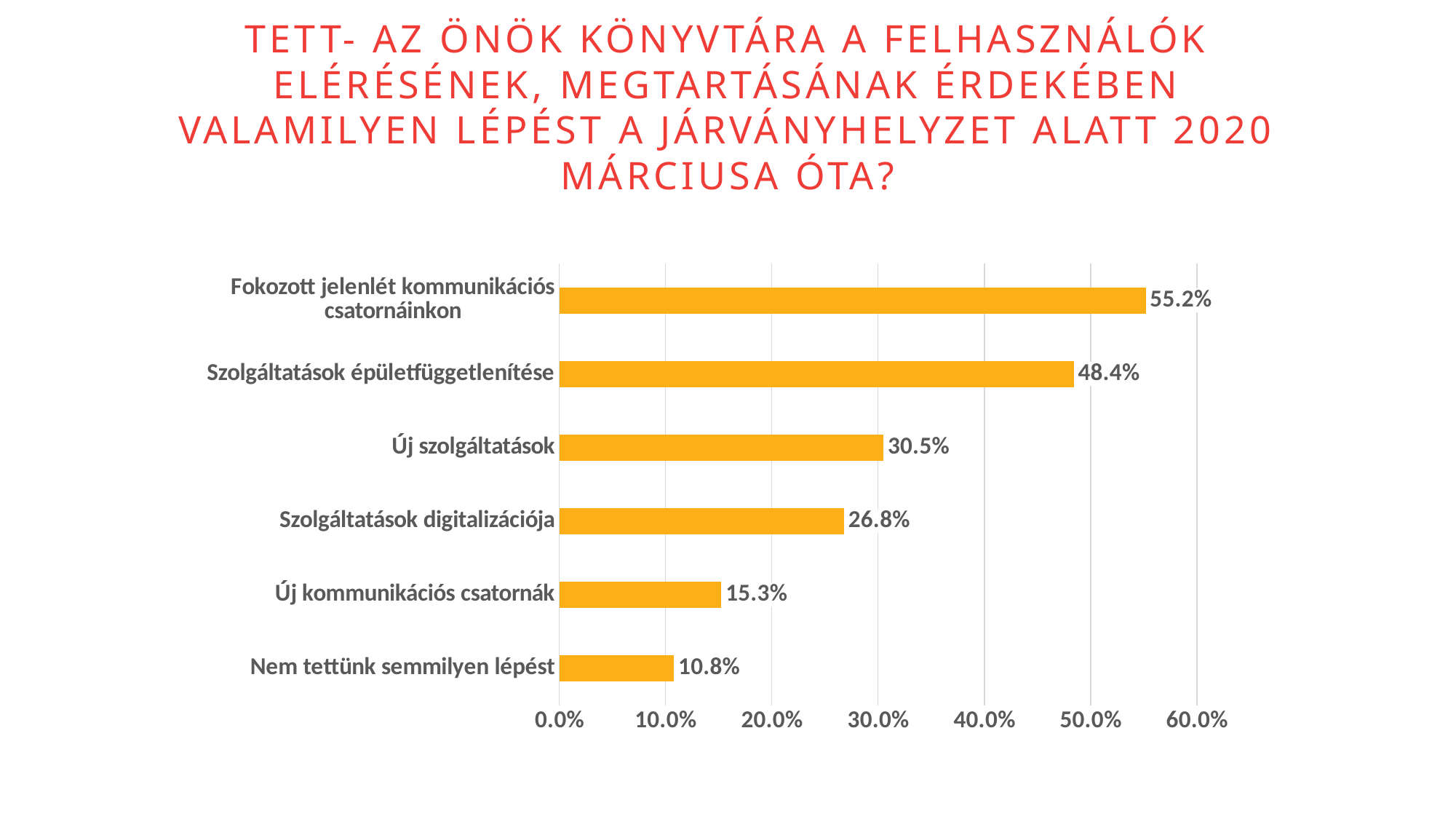
How many categories are shown in the chart? 6 Which category has the lowest value? Nem tettünk semmilyen lépést What is the value for "Új szolgáltatások"? 30.5% What is the value for "Nem tettünk semmilyen lépést"? 10.8% Is the value for "Szolgáltatások épületfüggetlenítése" greater or less than 40.0%? greater What is the difference between "Szolgáltatások épületfüggetlenítése" and "Szolgáltatások digitalizációja"? 21.6% Which category has the highest value? Fokozott jelenlét kommunikációs csatornáinkon What is the difference between the highest and lowest values in the chart? 44.4% Which is larger: "Új kommunikációs csatornák" or "Szolgáltatások digitalizációja"? Szolgáltatások digitalizációja What kind of chart is shown on the slide? Bar chart What is the maximum value shown on the horizontal axis? 60.0% What is the value for "Fokozott jelenlét kommunikációs csatornáinkon"? 55.2%